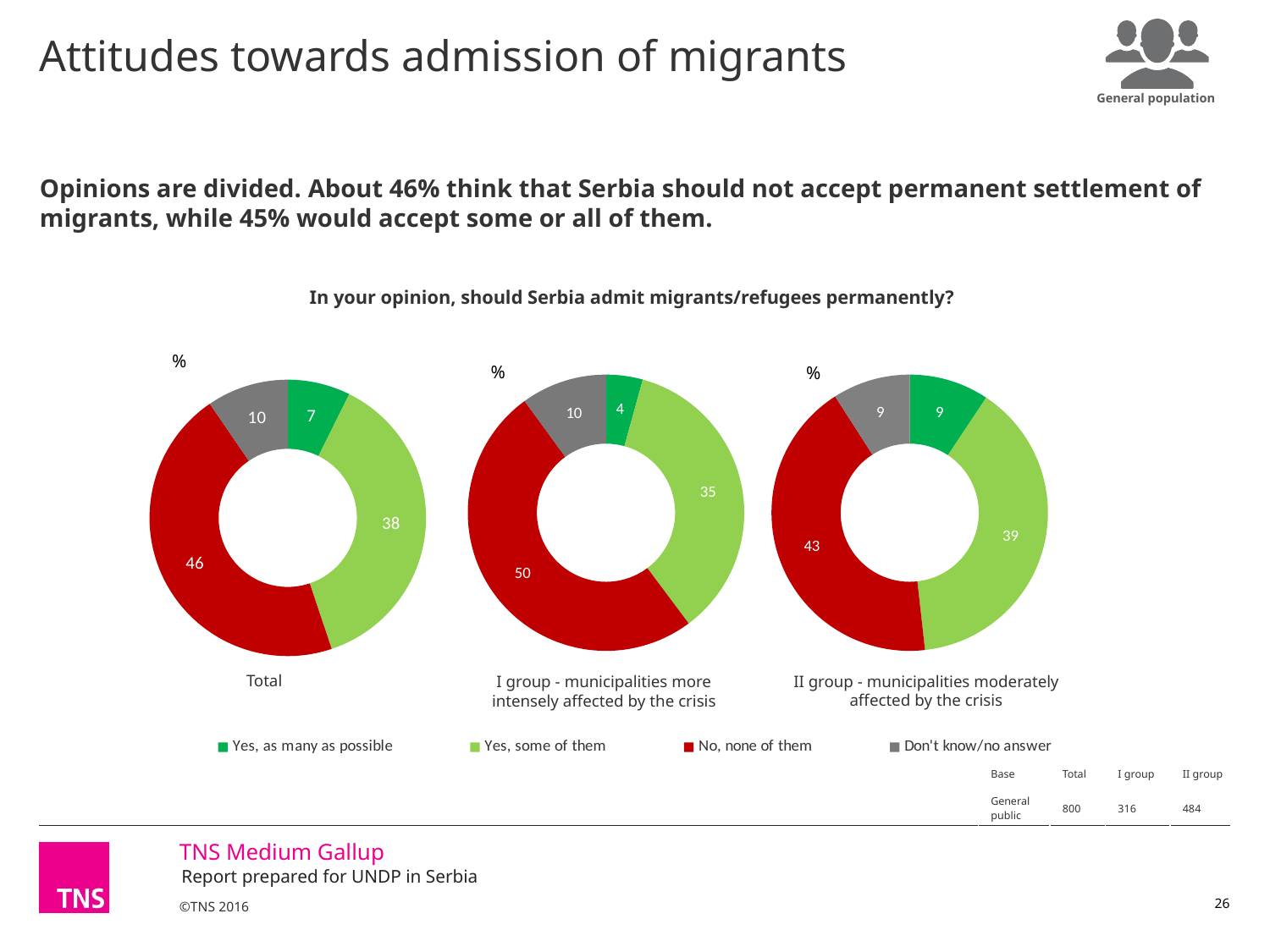
What colour represents 'No, none of them' in the charts? Red How many donut charts are shown on the slide? 3 In the 'II group - municipalities moderately affected by the crisis' chart, what is the value for 'Yes, as many as possible'? 9 In the 'I group' chart, which response category has the largest share? No, none of them In the 'Total' donut chart, what is the value for 'No, none of them'? 46 In the 'II group' chart, what is the difference between 'No, none of them' and 'Yes, some of them'? 4 What kind of chart is used on this slide? Pie (donut) chart How many series does the legend list? 4 Is the value for 'No, none of them' larger in the 'I group' chart or in the 'II group' chart? I group In the 'Total' chart, which response category has the smallest share? Yes, as many as possible In the 'I group - municipalities more intensely affected by the crisis' chart, what is the value for 'Yes, some of them'? 35 In the 'Total' chart, what share of the pie does 'Yes, some of them' represent? 38%